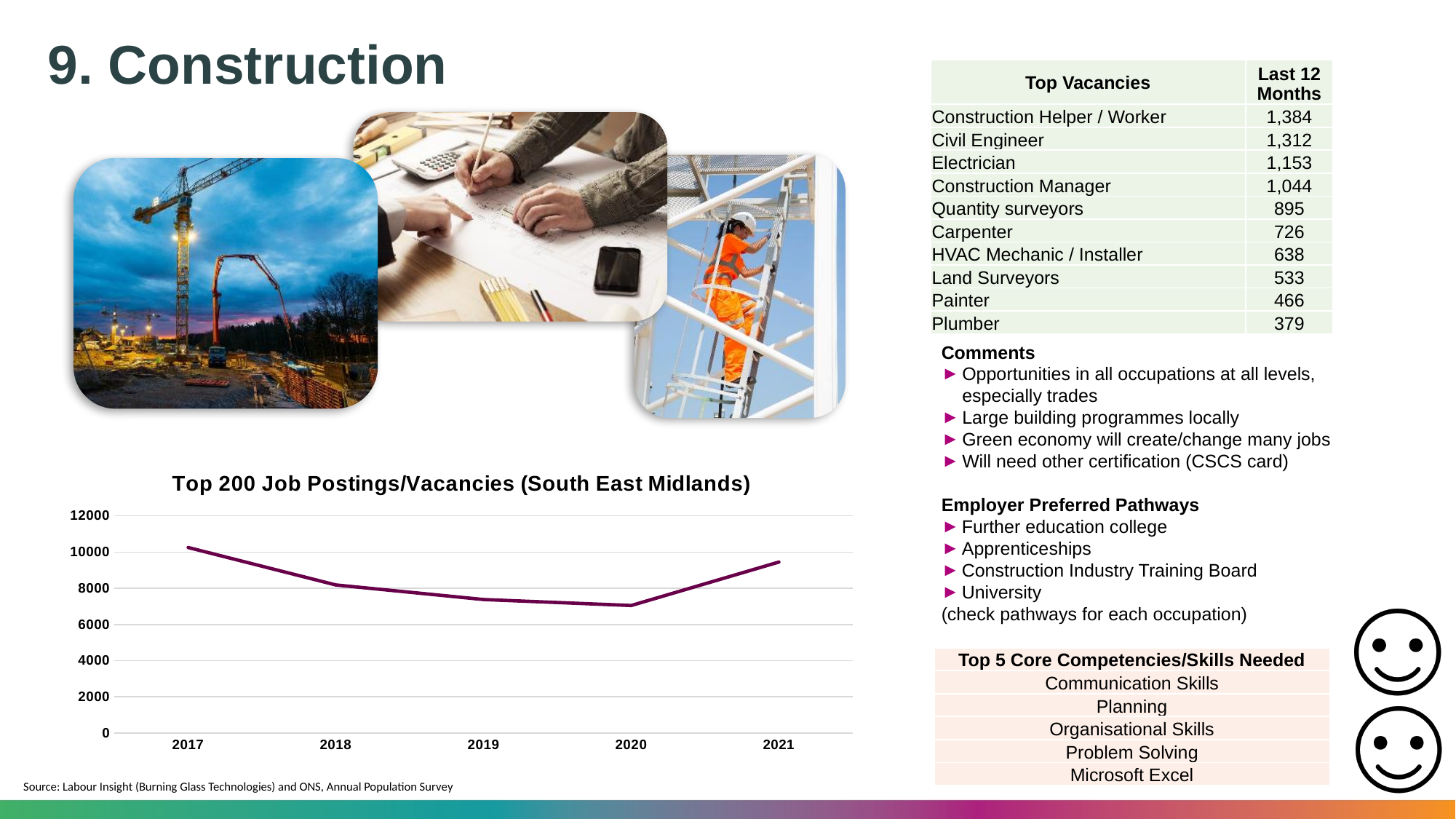
Which year has the lowest value in the line chart? 2020 Is the value for 2021 in the line chart greater or less than 8000? greater Is the value for 2017 in the line chart greater or less than 10000? greater Which year has the highest value in the line chart? 2017 What is the title of the line chart on the slide? Top 200 Job Postings/Vacancies (South East Midlands) What kind of chart is shown under the title "Top 200 Job Postings/Vacancies (South East Midlands)"? line chart Is the value for 2020 in the line chart greater or less than 8000? less Do the values in the line chart rise or fall from 2020 to 2021? rise Do the values in the line chart rise or fall from 2017 to 2020? fall In the line chart, which year has the larger value, 2018 or 2021? 2021 How many years are plotted on the x axis of the line chart? 5